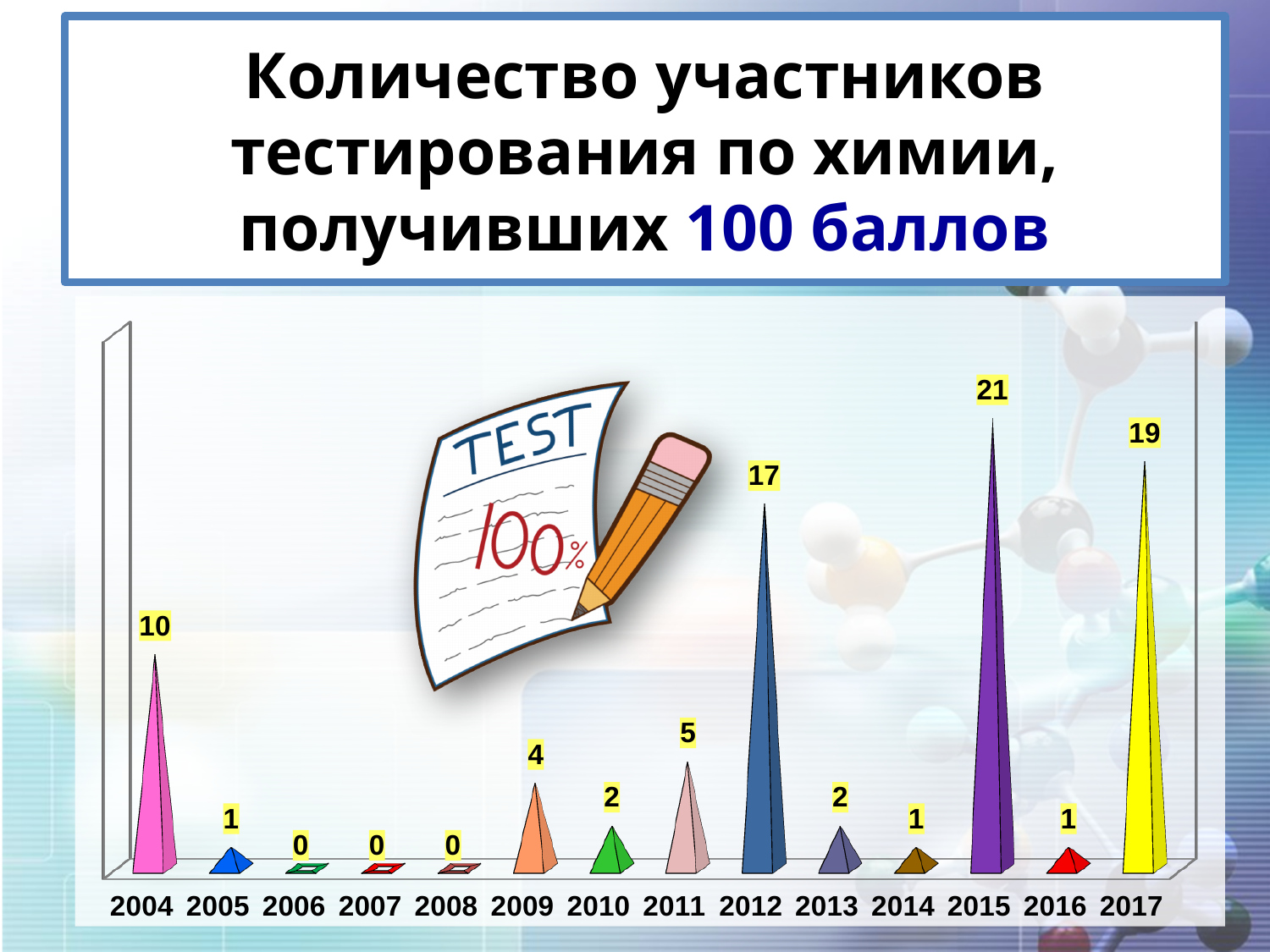
What is the value shown for 2011? 5 What kind of chart is shown? bar chart What is the value shown for 2004? 10 What is the difference between the values for 2015 and 2017? 2 Which year has the highest value? 2015 How many years are shown on the x axis? 14 Which is larger, the value for 2009 or the value for 2011? 2011 How many years have a value of 0? 3 What is the difference between the values for 2012 and 2004? 7 What is the title of the chart? Количество участников тестирования по химии, получивших 100 баллов How many participants scored 100 points in 2012? 17